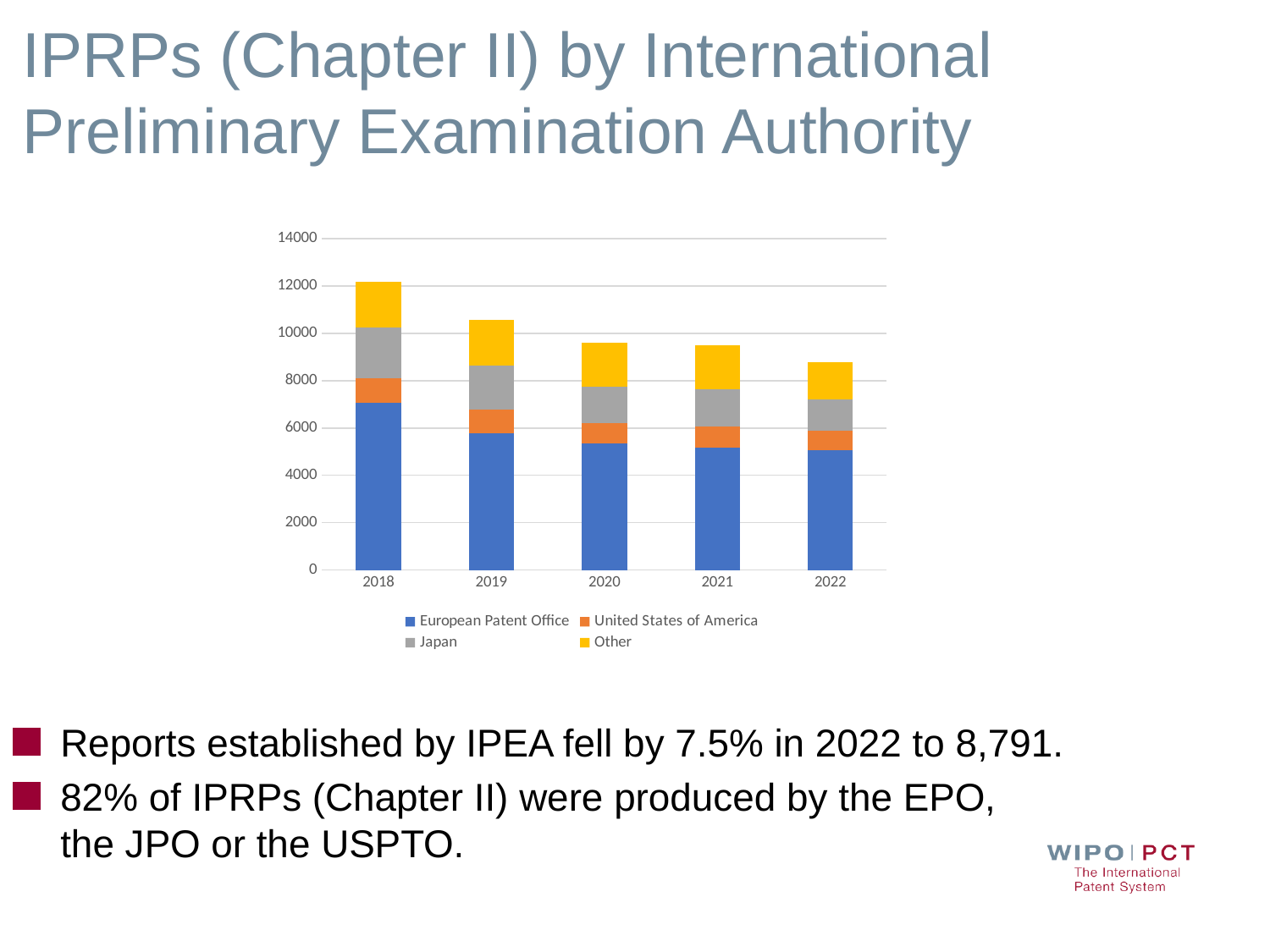
Is the European Patent Office value for 2018 greater or less than 6000? greater Which colour represents Japan in the chart's legend? grey Which is larger, the European Patent Office value for 2018 or for 2022? 2018 Which year has the tallest stacked bar (highest total) in the chart? 2018 Which series forms the largest segment of each stacked bar? European Patent Office Is the total for 2018 greater or less than 10000? greater Which year has the shortest stacked bar (lowest total) in the chart? 2022 Do the total bar heights rise or fall from 2018 to 2022? fall How many years are shown on the x axis of the chart? 5 What kind of chart is shown on the slide? stacked bar chart How many series does the chart's legend list? 4 Is the total for 2022 greater or less than 10000? less